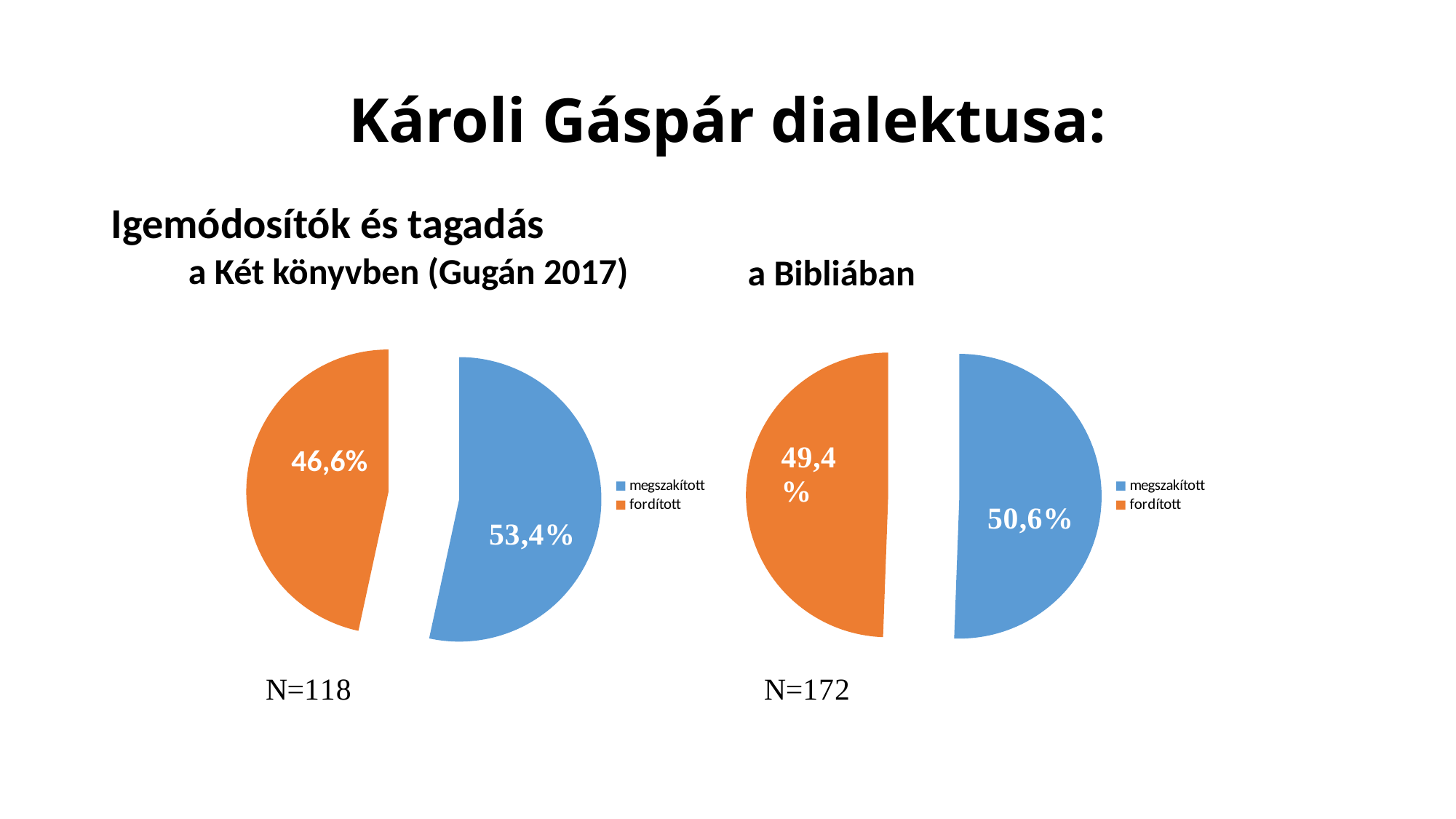
In the left pie chart (a Két könyvben), which category has the larger share? megszakított What type of chart is used for the a Bibliában data? pie chart In the left pie chart (a Két könyvben), which category has the smaller share? fordított In the right pie chart (a Bibliában), what share is labelled for the fordított slice? 49,4% How many categories does the legend of the left pie chart (a Két könyvben) list? 2 Which colour represents fordított in the pie charts? orange In the left pie chart (a Két könyvben), what share is labelled for the megszakított slice? 53,4% In the left pie chart (a Két könyvben), what share is labelled for the fordított slice? 46,6% In the left pie chart (a Két könyvben), by how many percentage points does megszakított exceed fordított? 6,8 In the right pie chart (a Bibliában), by how many percentage points does megszakított exceed fordított? 1,2 What is the N value shown under the right pie chart (a Bibliában)? N=172 In the right pie chart (a Bibliában), what share is labelled for the megszakított slice? 50,6%